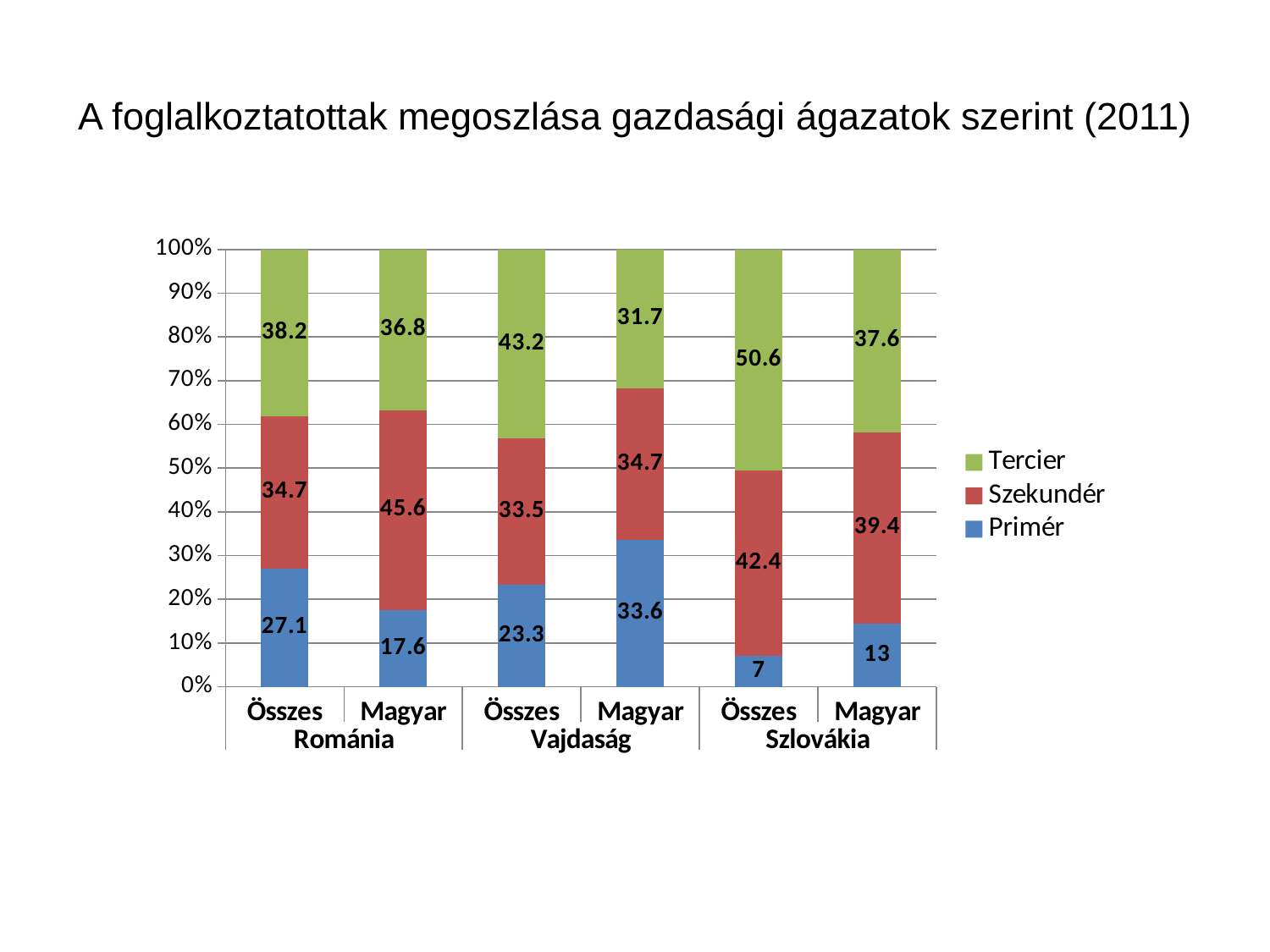
What kind of chart is shown on the slide? Stacked bar chart Which bar has the highest Primér value? Vajdaság Magyar What is the difference between the Szekundér values for Magyar and Összes in Románia? 10.9 How many bars are shown in the chart? 6 What is the difference between the Primér values for Magyar and Összes in Szlovákia? 6 What is the Primér value for Összes in Románia? 27.1 Which bar has the highest Szekundér value? Románia Magyar In Vajdaság, which has the larger Tercier value, Összes or Magyar? Összes What is the Szekundér value for Magyar in Vajdaság? 34.7 What is the Tercier value for Összes in Szlovákia? 50.6 Which bar has the lowest Primér value? Szlovákia Összes How many series does the legend list? 3